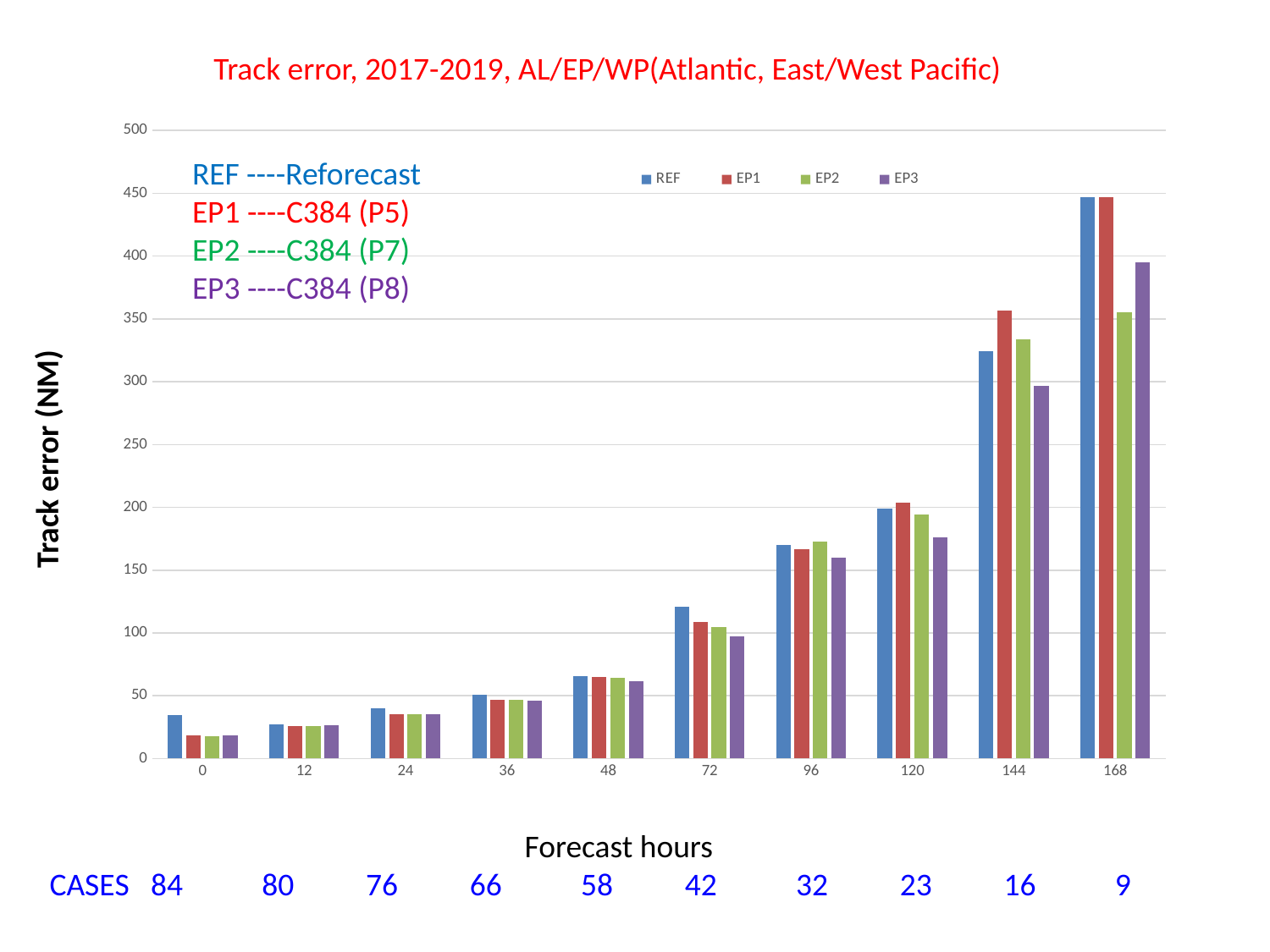
Is the value for EP3 at 168 forecast hours greater or less than 350? greater Which series has the highest track error at 144 forecast hours? EP1 Do the REF values rise or fall as forecast hours increase along the x axis? rise Is the value for REF at 144 forecast hours greater or less than 300? greater What is the label of the y axis? Track error (NM) What kind of chart is shown on the slide? bar chart At 144 forecast hours, which is larger, EP1 or EP3? EP1 Which series has the lowest track error at 168 forecast hours? EP2 How many series does the legend list? 4 Is the value for EP3 at 120 forecast hours greater or less than 200? less How many forecast-hour categories are shown on the x axis? 10